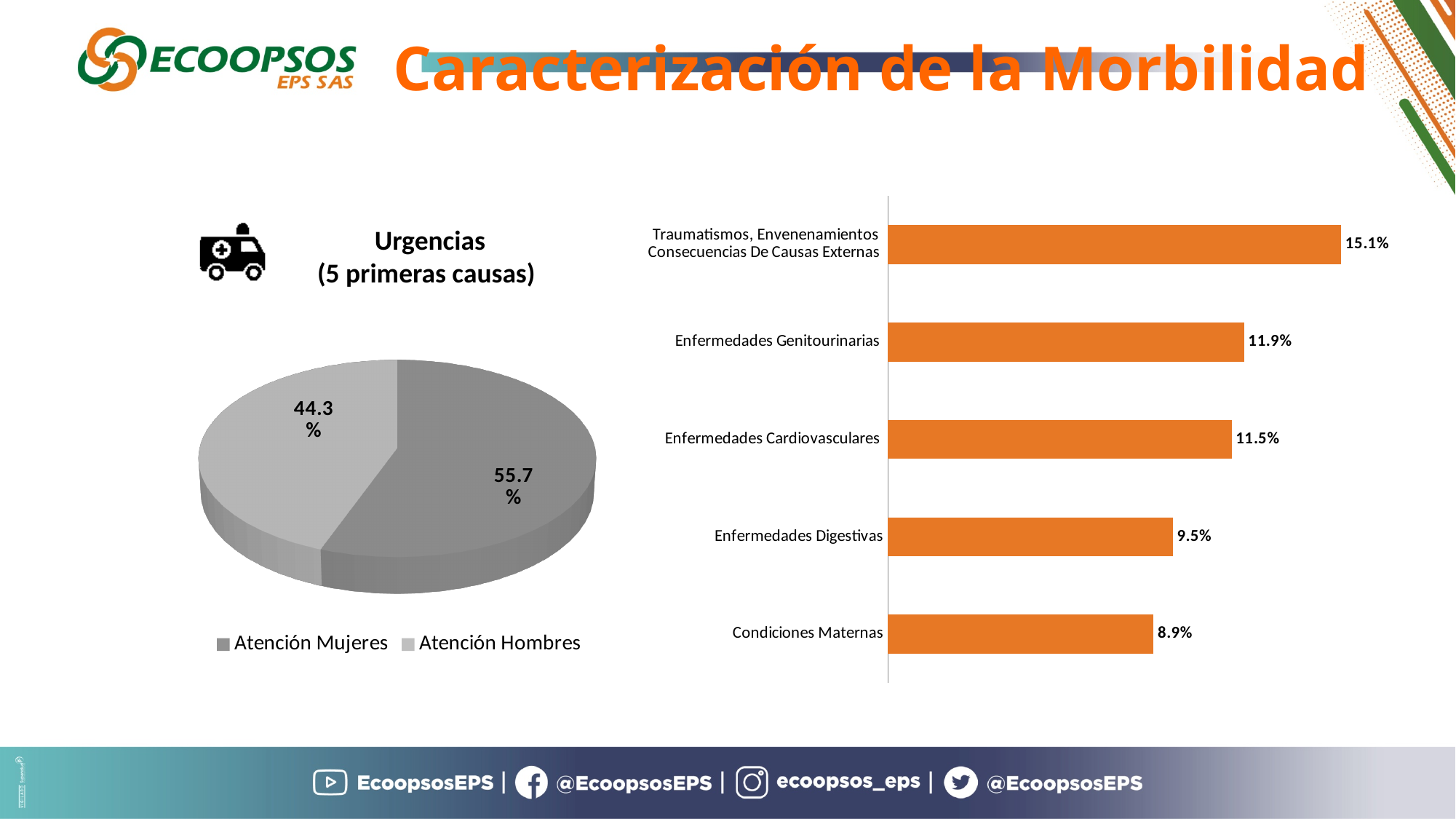
In the bar chart on the right, what is the value for Condiciones Maternas? 8.9% In the pie chart on the left, what is the difference between the Atención Mujeres and Atención Hombres shares? 11.4% How many categories are shown in the bar chart on the right? 5 In the bar chart on the right, which category has the lowest value? Condiciones Maternas In the bar chart on the right, what is the difference between Enfermedades Cardiovasculares and Enfermedades Digestivas? 2.0% In the pie chart on the left, which slice is larger, Atención Mujeres or Atención Hombres? Atención Mujeres In the bar chart on the right, what is the value for Enfermedades Genitourinarias? 11.9% In the bar chart on the right, which category has the highest value? Traumatismos, Envenenamientos Consecuencias De Causas Externas What kind of chart is the chart on the left of the slide? Pie chart How many entries does the legend of the pie chart on the left list? 2 In the pie chart on the left, what share is labelled for Atención Hombres? 44.3% In the pie chart on the left, what share is labelled for Atención Mujeres? 55.7%